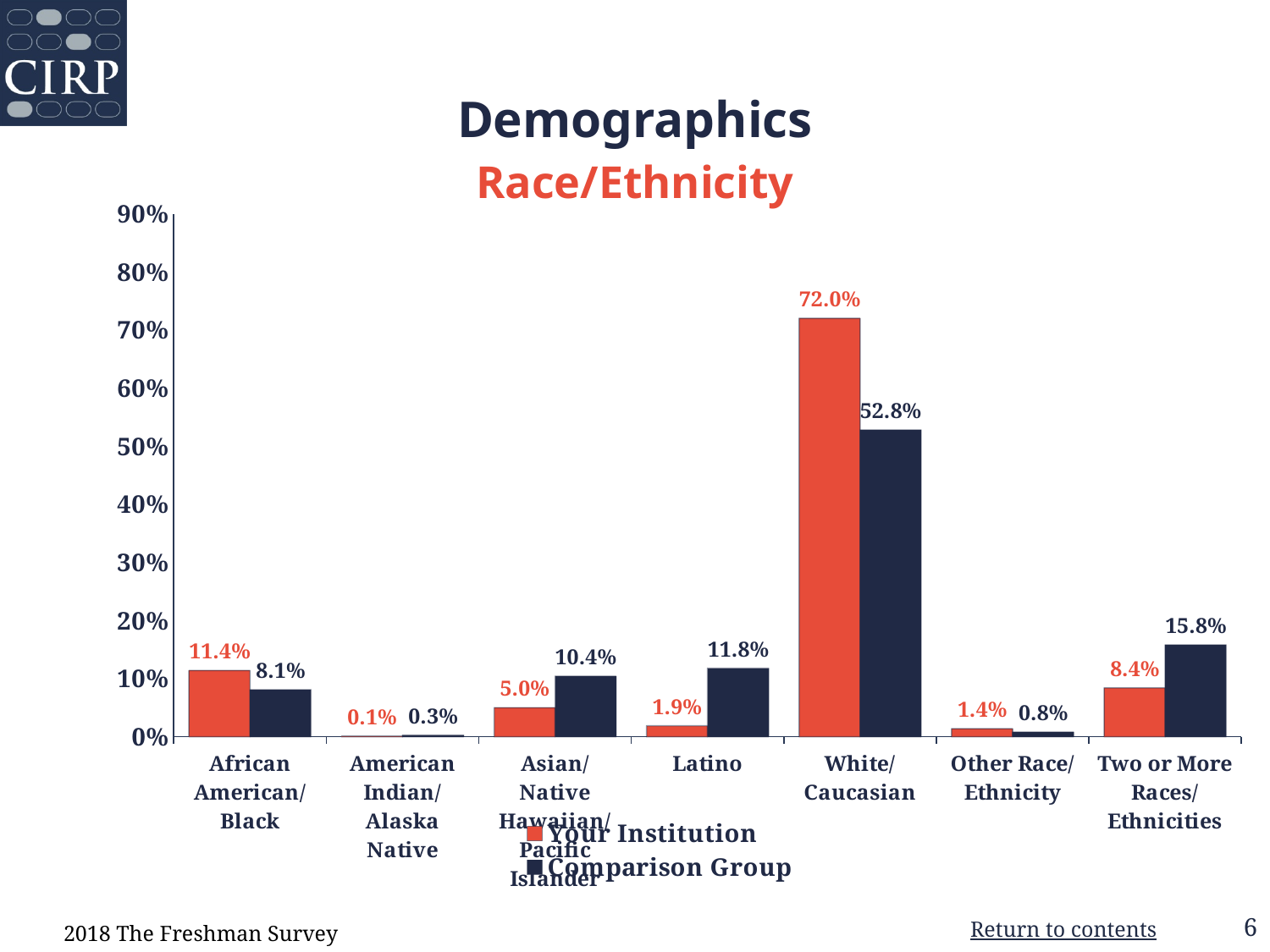
What kind of chart is shown on the slide? Bar chart Is the Your Institution value for White/Caucasian greater or less than 70%? greater How many series does the legend list? 2 What is the Comparison Group value for Two or More Races/Ethnicities? 15.8% How many race/ethnicity categories are shown on the x axis? 7 Which category has the highest Comparison Group value? White/Caucasian Which category has the lowest Your Institution value? American Indian/Alaska Native What is the subtitle of the chart shown under 'Demographics'? Race/Ethnicity What is the Your Institution value for White/Caucasian? 72.0% For Latino, which series has the larger value, Your Institution or Comparison Group? Comparison Group What is the Your Institution value for Latino? 1.9% What is the difference between the Your Institution and Comparison Group values for White/Caucasian? 19.2%